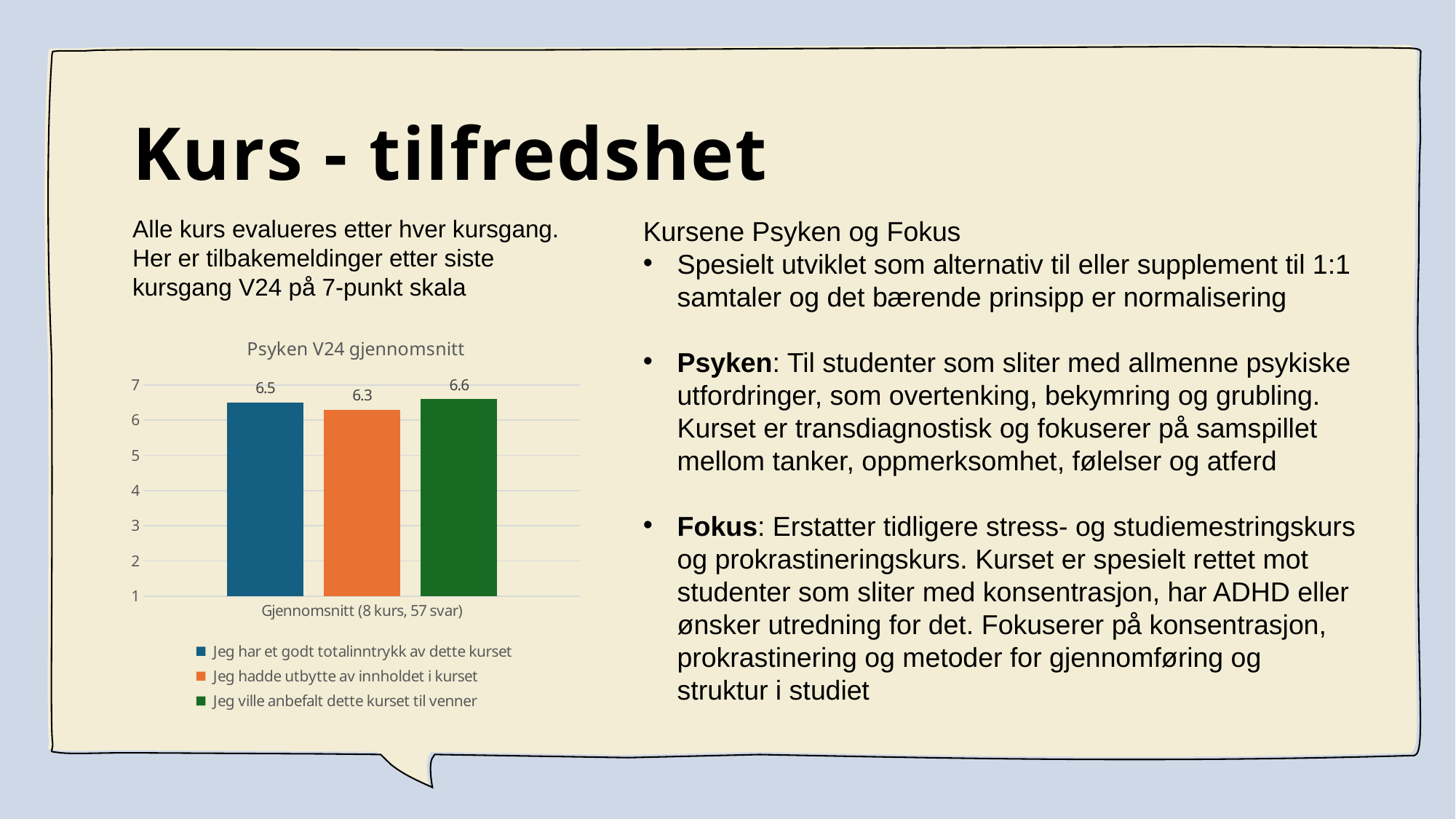
Is the value for "Jeg hadde utbytte av innholdet i kurset" greater or less than 6? greater How many series does the legend list? 3 What kind of chart is shown on the slide? bar chart What is the value for "Jeg hadde utbytte av innholdet i kurset"? 6.3 Which series has the lowest value? Jeg hadde utbytte av innholdet i kurset What is the value for "Jeg ville anbefalt dette kurset til venner"? 6.6 Which series has the highest value? Jeg ville anbefalt dette kurset til venner Which is larger: the value for "Jeg har et godt totalinntrykk av dette kurset" or the value for "Jeg hadde utbytte av innholdet i kurset"? Jeg har et godt totalinntrykk av dette kurset What is the difference between the value for "Jeg ville anbefalt dette kurset til venner" and the value for "Jeg hadde utbytte av innholdet i kurset"? 0.3 What is the title of the chart? Psyken V24 gjennomsnitt What is the value for "Jeg har et godt totalinntrykk av dette kurset"? 6.5 What is the label of the category on the x axis? Gjennomsnitt (8 kurs, 57 svar)